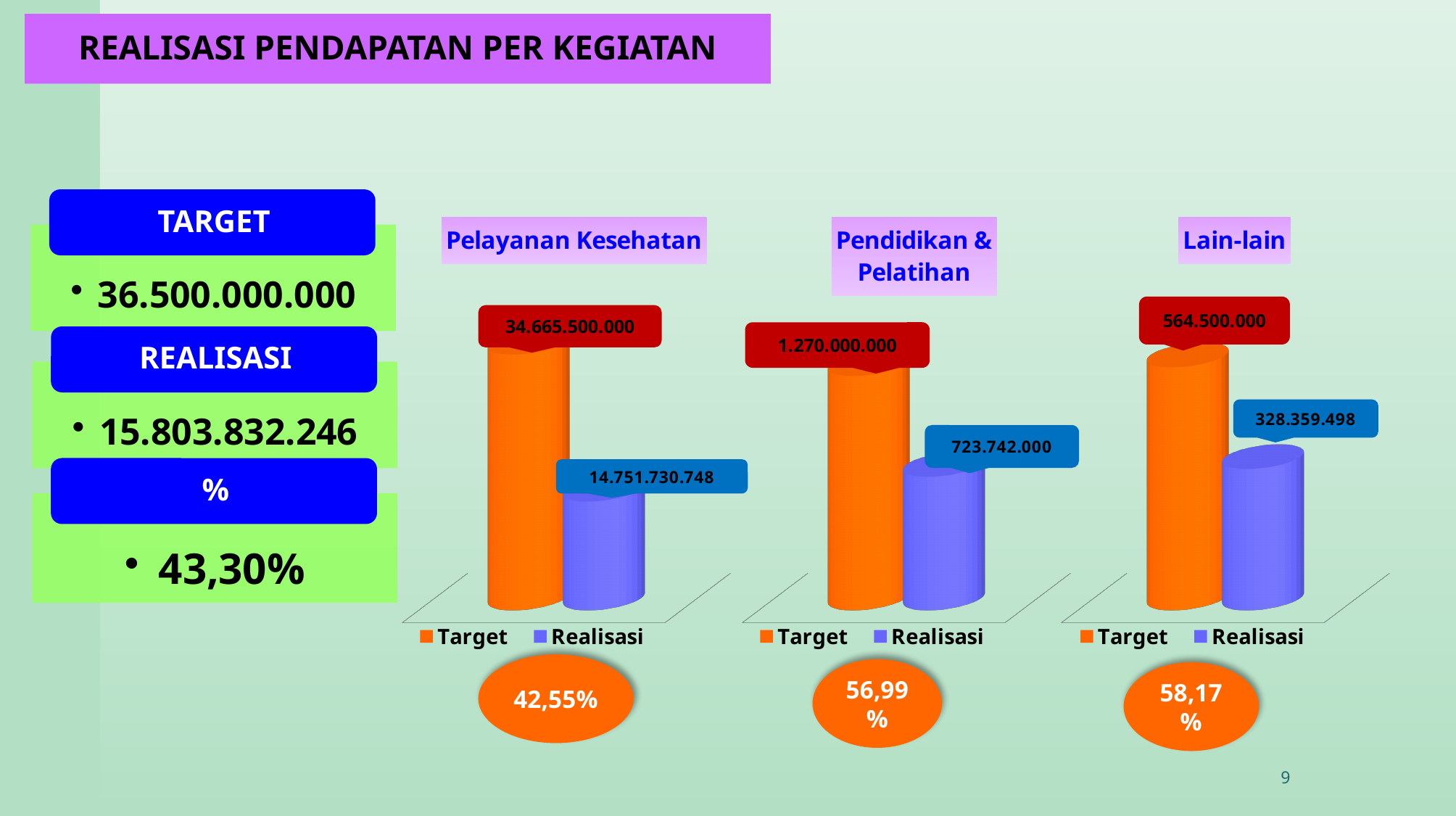
What type of chart is the Pendidikan & Pelatihan chart? Bar chart In the Lain-lain chart, what is the value of the Target bar? 564.500.000 In the Pelayanan Kesehatan chart, what is the value of the Target bar? 34.665.500.000 In the Pelayanan Kesehatan chart, which bar is taller, Target or Realisasi? Target In the Pendidikan & Pelatihan chart, what is the value of the Target bar? 1.270.000.000 In the Lain-lain chart, what is the difference between the Target and Realisasi values? 236.140.502 In the Pelayanan Kesehatan chart, what is the value of the Realisasi bar? 14.751.730.748 In the Pendidikan & Pelatihan chart, what is the difference between the Target and Realisasi values? 546.258.000 In the Pelayanan Kesehatan chart, what colour is the Realisasi bar? Blue How many series does the legend of the Lain-lain chart list? 2 In the Pendidikan & Pelatihan chart, what is the value of the Realisasi bar? 723.742.000 In the Lain-lain chart, what is the value of the Realisasi bar? 328.359.498